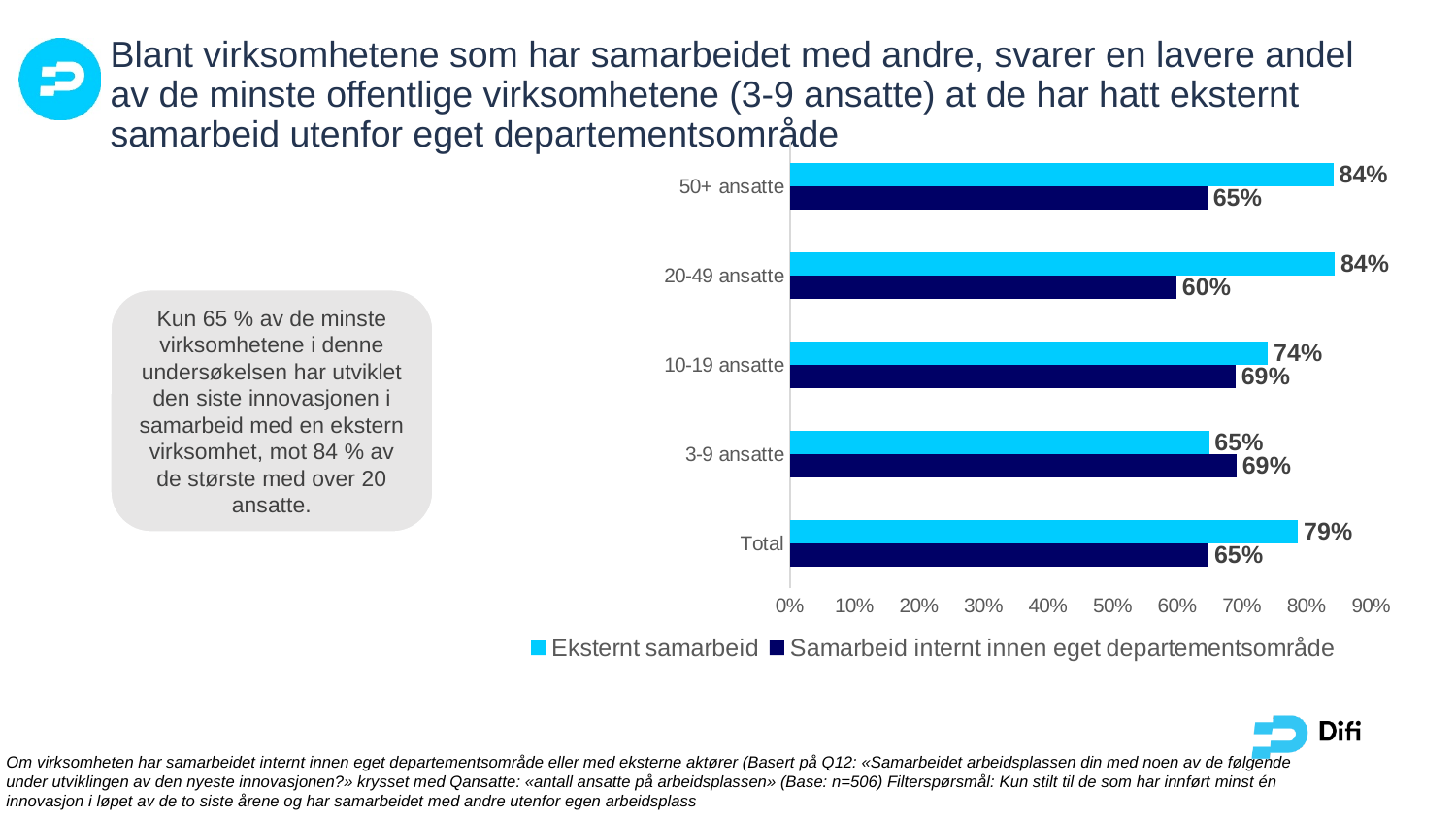
What is the difference between Eksternt samarbeid and Samarbeid internt innen eget departementsområde for 50+ ansatte? 19 percentage points How many categories are shown on the chart? 5 Which category has the lowest value for Samarbeid internt innen eget departementsområde? 20-49 ansatte For 3-9 ansatte, which is larger: Eksternt samarbeid or Samarbeid internt innen eget departementsområde? Samarbeid internt innen eget departementsområde What is the value for Samarbeid internt innen eget departementsområde for 10-19 ansatte? 69% What is the value for Eksternt samarbeid for Total? 79% What kind of chart is shown on the slide? Bar chart How many series does the legend list? 2 What is the value for Samarbeid internt innen eget departementsområde for 20-49 ansatte? 60% Which colour represents Eksternt samarbeid in the chart? Light blue Which category has the lowest value for Eksternt samarbeid? 3-9 ansatte What is the value for Eksternt samarbeid for 3-9 ansatte? 65%